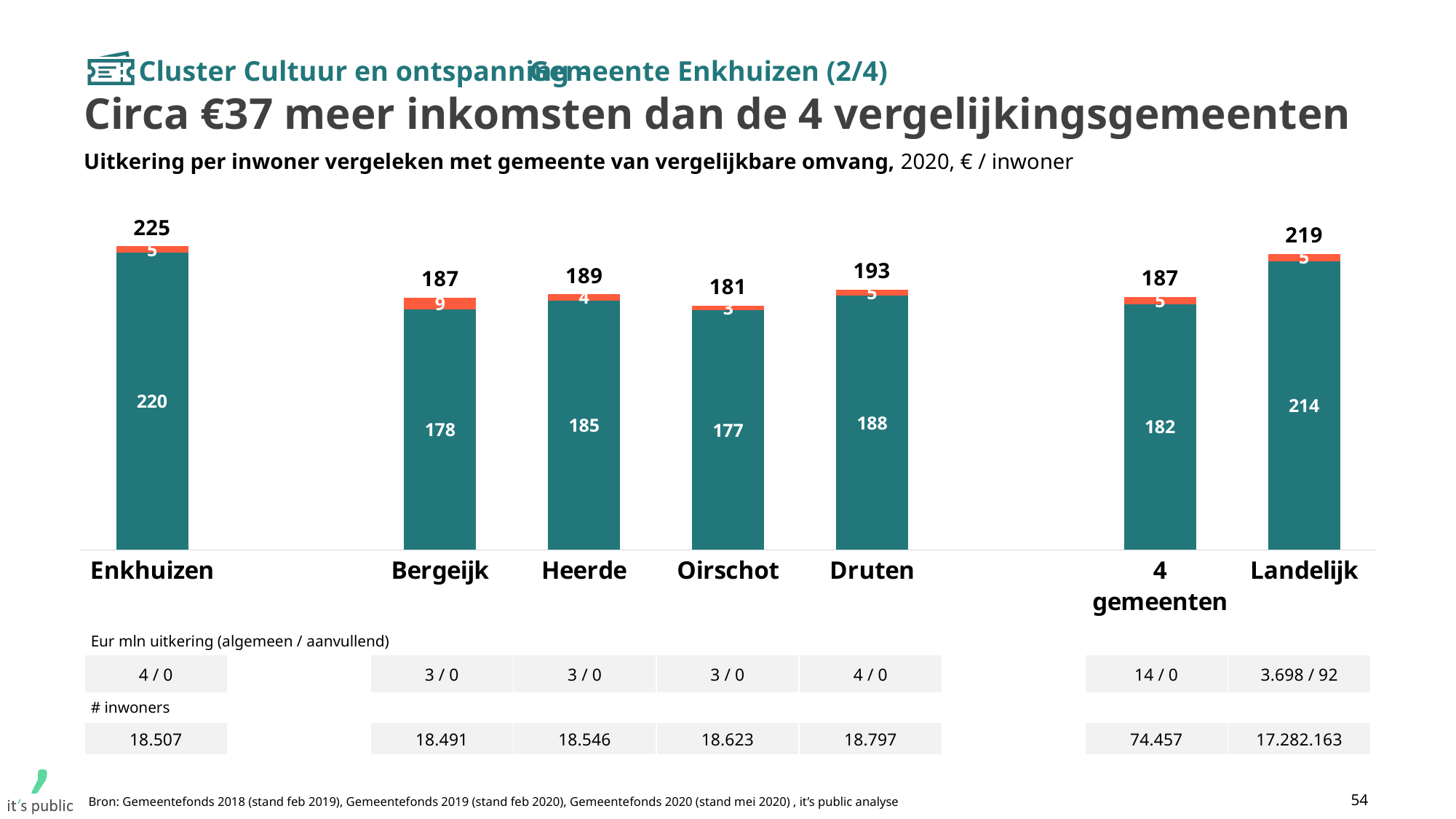
Which category has the highest total value? Enkhuizen What is the total value shown above the bar for Enkhuizen? 225 Which has a larger total value, Heerde or Druten? Druten What is the value of the teal (lower) segment for Bergeijk? 178 What is the value of the teal segment for Druten? 188 What is the number of inhabitants (# inwoners) listed for Enkhuizen below the chart? 18.507 What is the difference between the total for Enkhuizen and the total for 4 gemeenten? 38 What kind of chart is shown on the slide? Stacked bar chart What is the value of the orange (upper) segment for Bergeijk? 9 Which category has the lowest total value? Oirschot What is the total value shown above the bar for Landelijk? 219 How many bars are shown in the chart? 7